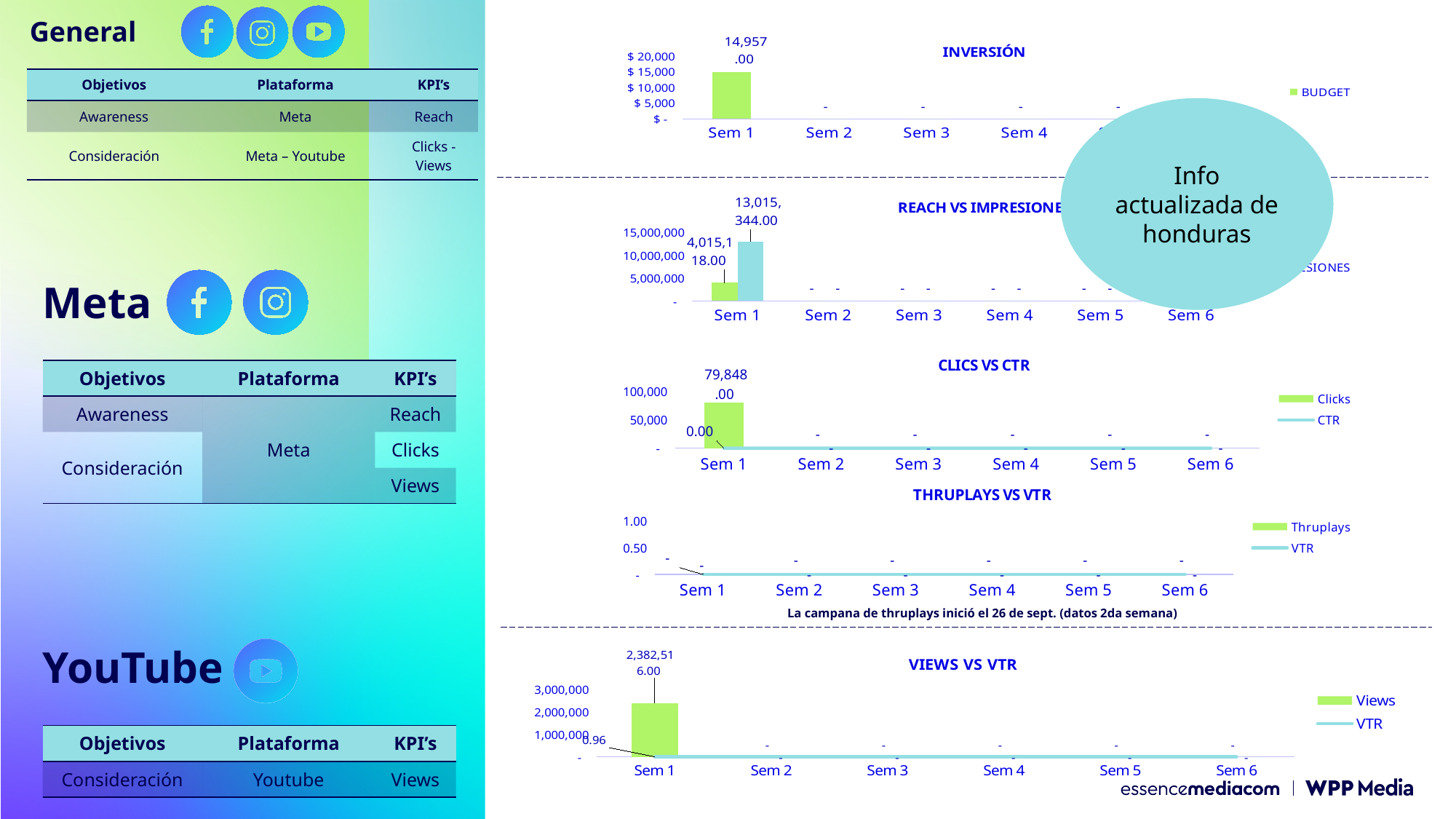
In the INVERSIÓN chart, what is the value for Sem 1? 14,957.00 In the VIEWS VS VTR chart, what is the VTR value for Sem 1? 0.96 In the REACH VS IMPRESIONES chart, what is the value of the taller bar for Sem 1? 13,015,344.00 In the INVERSIÓN chart, is the value for Sem 1 greater or less than $ 10,000? greater In the REACH VS IMPRESIONES chart, what is the value of the shorter bar for Sem 1? 4,015,118.00 In the REACH VS IMPRESIONES chart, what is the difference between the two Sem 1 values? 9,000,226.00 In the THRUPLAYS VS VTR chart, which series does the legend list? Thruplays, VTR In the INVERSIÓN chart, which series does the legend list? BUDGET In the VIEWS VS VTR chart, what is the Views value for Sem 1? 2,382,516.00 In the CLICS VS CTR chart, how many series does the legend list? 2 In the CLICS VS CTR chart, what is the Clicks value for Sem 1? 79,848.00 In the REACH VS IMPRESIONES chart, how many categories are shown on the x axis? 6